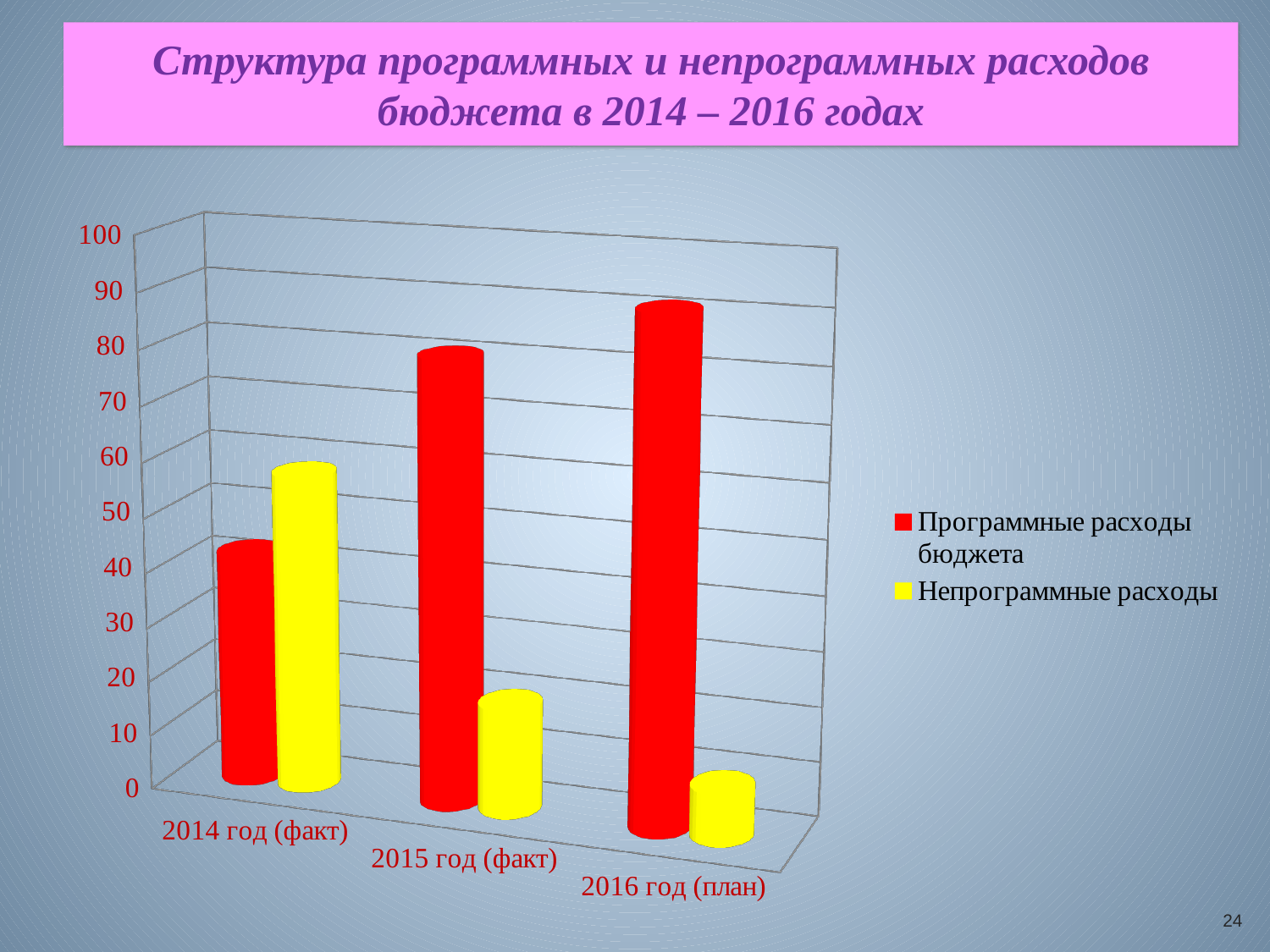
What kind of chart is shown on the slide? bar chart How many series does the chart legend list? 2 Is the value for Программные расходы бюджета in 2016 год (план) greater or less than 70? greater In 2014 год (факт), which is larger: Программные расходы бюджета or Непрограммные расходы? Непрограммные расходы Which year has the lowest value for Программные расходы бюджета? 2014 год (факт) Which year has the highest value for Программные расходы бюджета? 2016 год (план) Which colour represents Непрограммные расходы in the chart? yellow Do the values for Программные расходы бюджета rise or fall from 2014 to 2016? rise In 2015 год (факт), which is larger: Программные расходы бюджета or Непрограммные расходы? Программные расходы бюджета How many categories (years) are shown on the x axis of the chart? 3 Which year has the lowest value for Непрограммные расходы? 2016 год (план) Is the value for Непрограммные расходы in 2015 год (факт) greater or less than 40? less